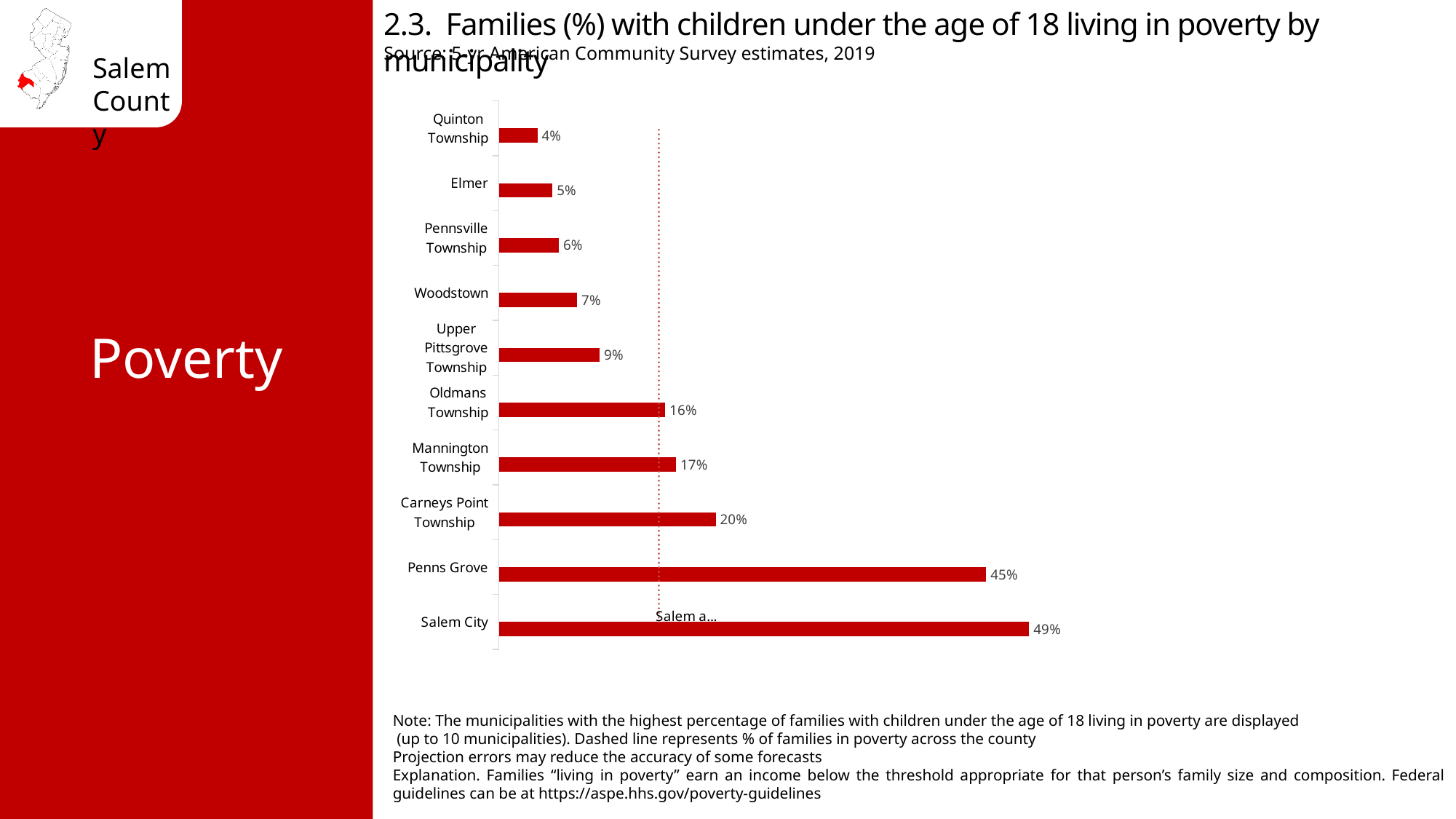
Which has a higher value, Mannington Township or Oldmans Township? Mannington Township Which municipality has the highest percentage of families with children under 18 living in poverty? Salem City What is the value for Quinton Township? 4% What percentage of families with children under 18 are living in poverty in Salem City? 49% What percentage is shown for Carneys Point Township? 20% What is the value shown for Penns Grove? 45% What is the difference in percentage points between Carneys Point Township and Woodstown? 13 Which municipality has the lowest percentage shown on the chart? Quinton Township How many municipalities are shown on the chart? 10 What is the difference in percentage points between Salem City and Penns Grove? 4 What type of chart is used on this slide? Bar chart According to the note, what does the dashed line on the chart represent? % of families in poverty across the county